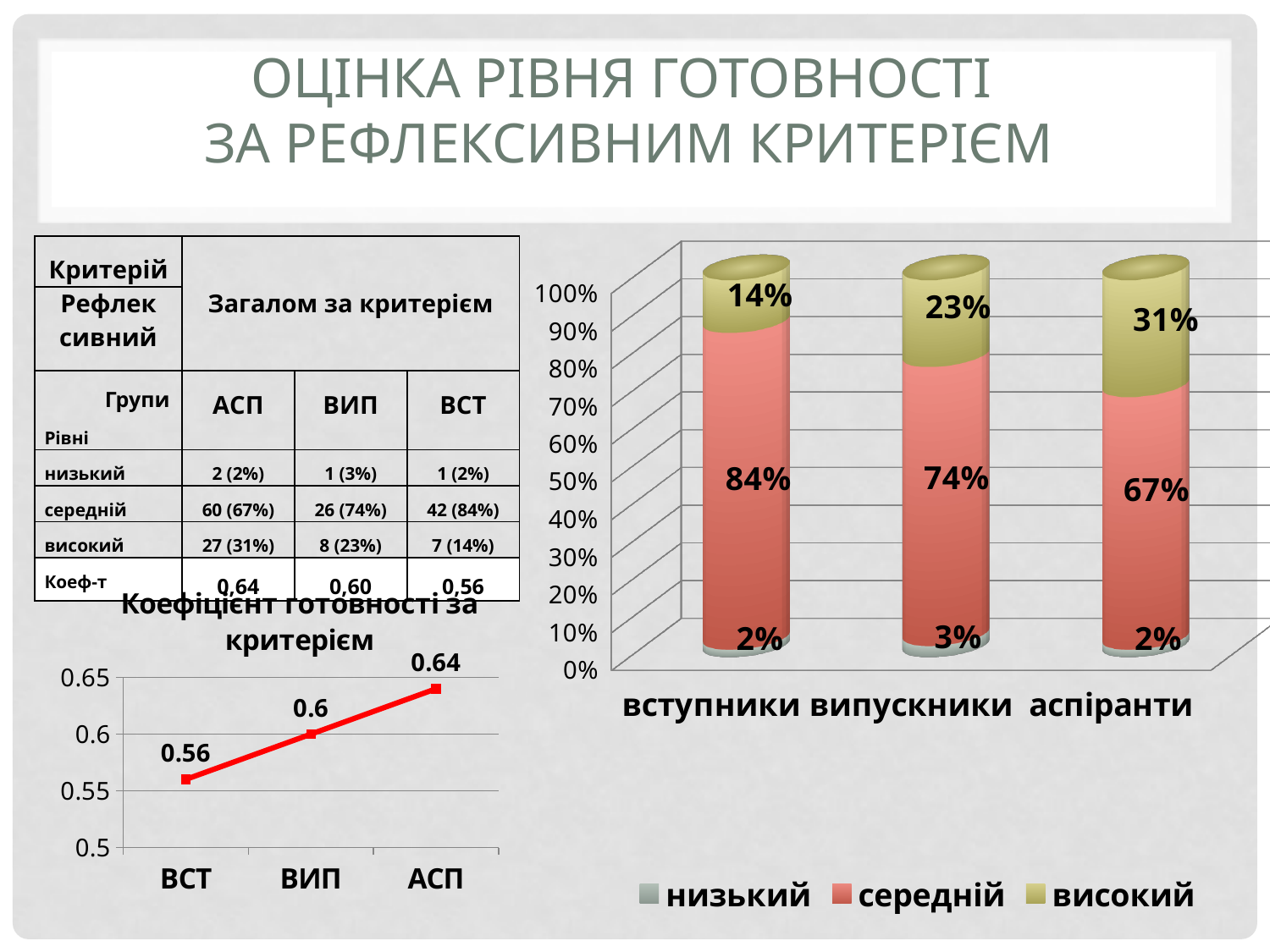
In the stacked bar chart on the right, is the 'середній' segment larger for вступники or for аспіранти? вступники In the line chart titled 'Коефіцієнт готовності за критерієм', do the values rise or fall from ВСТ to АСП? rise In the line chart titled 'Коефіцієнт готовності за критерієм', which category has the highest value? АСП In the stacked bar chart on the right, how many series does the legend list? 3 In the stacked bar chart on the right, what is the value of the 'середній' segment for випускники? 74% In the line chart titled 'Коефіцієнт готовності за критерієм', what is the difference between the values for АСП and ВСТ? 0.08 What type of chart is the chart on the right side of the slide? stacked bar chart In the line chart titled 'Коефіцієнт готовності за критерієм', what is the value for ВИП? 0.6 In the line chart titled 'Коефіцієнт готовності за критерієм', which category has the lowest value? ВСТ In the stacked bar chart on the right, what is the value of the 'високий' segment for аспіранти? 31% In the stacked bar chart on the right, which category has the largest 'високий' segment? аспіранти In the line chart titled 'Коефіцієнт готовності за критерієм', how many data points are plotted? 3